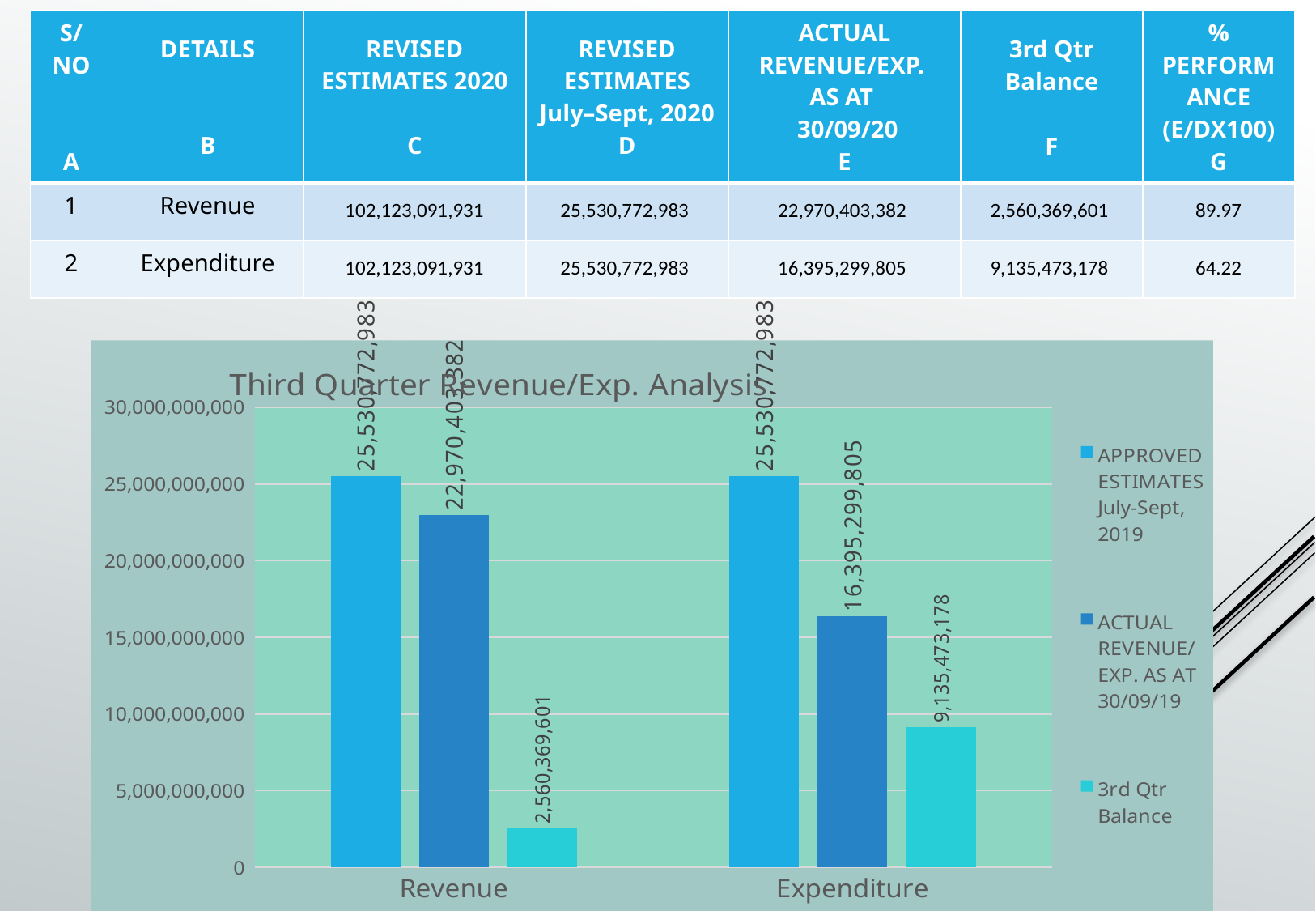
What type of chart is shown on the slide? bar chart Is the 3rd Qtr Balance value for Revenue greater or less than 5,000,000,000? less What is the value of the 3rd Qtr Balance bar for Expenditure? 9,135,473,178 What is the difference between the ACTUAL REVENUE/EXP. AS AT 30/09/19 values for Revenue and Expenditure? 6,575,103,577 What is the value of the ACTUAL REVENUE/EXP. AS AT 30/09/19 bar for Expenditure? 16,395,299,805 What is the value of the 3rd Qtr Balance bar for Revenue? 2,560,369,601 Which series has the lowest value in the Revenue category? 3rd Qtr Balance How many categories are shown on the x axis of the chart? 2 What is the title of the chart? Third Quarter Revenue/Exp. Analysis What is the value of the APPROVED ESTIMATES July-Sept, 2019 bar for Revenue? 25,530,772,983 How many series does the chart legend list? 3 Which category has the higher 3rd Qtr Balance value, Revenue or Expenditure? Expenditure